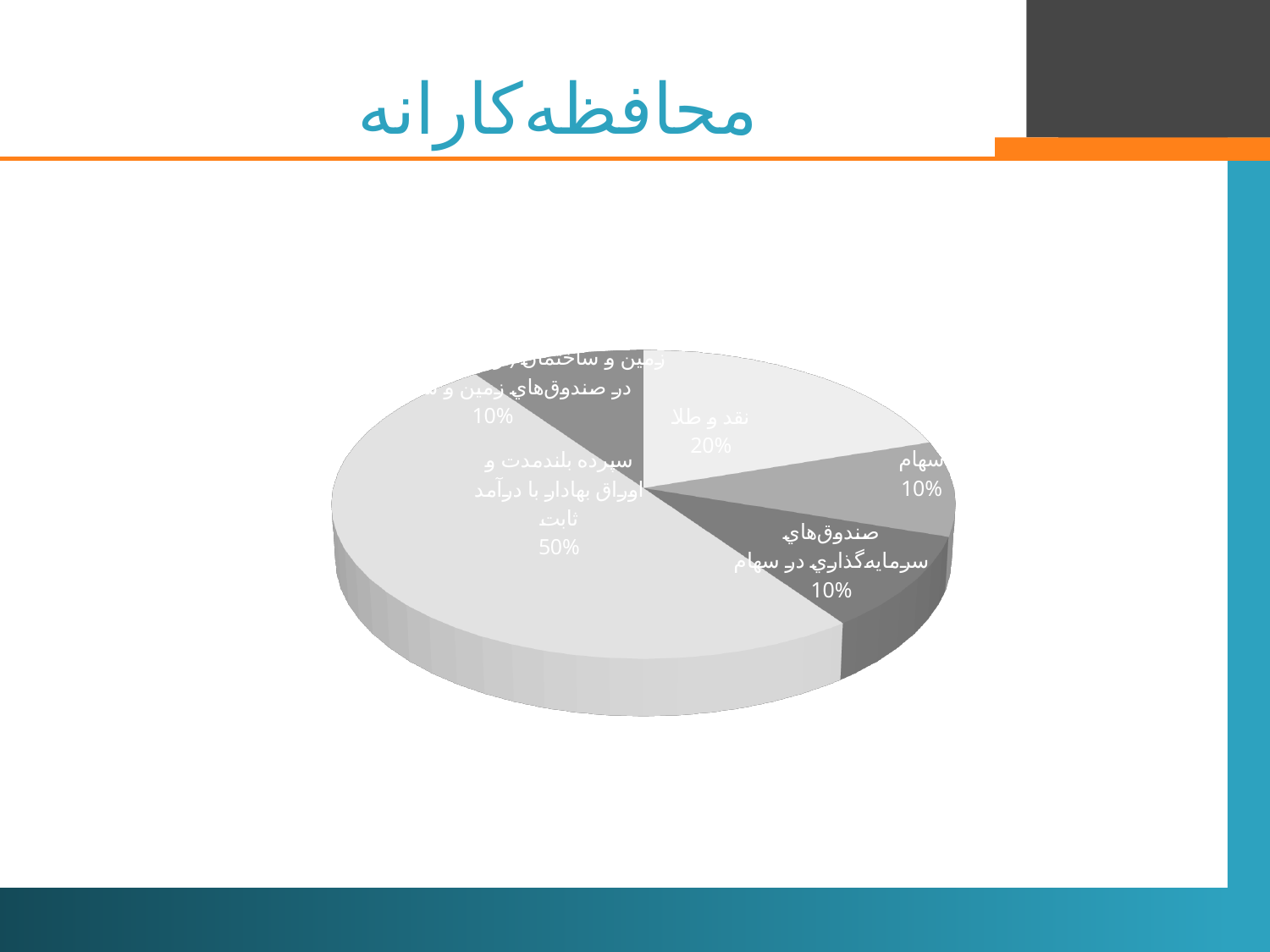
What is the difference in percentage points between the "سپرده بلندمدت و اوراق بهادار با درآمد ثابت" slice and the "نقد و طلا" slice? 30 percentage points Which is larger: the "نقد و طلا" slice or the "سهام" slice? نقد و طلا Which slice of the pie chart is the largest? سپرده بلندمدت و اوراق بهادار با درآمد ثابت (50%) What is the title of the slide containing the pie chart? محافظه‌کارانه What percentage does the slice labelled "سپرده بلندمدت و اوراق بهادار با درآمد ثابت" (long-term deposits and fixed-income securities) represent? 50% What percentage does the slice labelled "سهام" (stocks) represent? 10% How many slices in the pie chart are labelled 10%? 3 What percentage does the slice labelled "صندوق‌های سرمایه‌گذاری در سهام" (equity investment funds) represent? 10% What share of the pie do the "نقد و طلا" and "سهام" slices make up together? 30% How many slices does the pie chart have? 5 What kind of chart is shown on the slide? Pie chart What percentage does the slice labelled "نقد و طلا" (cash and gold) represent? 20%